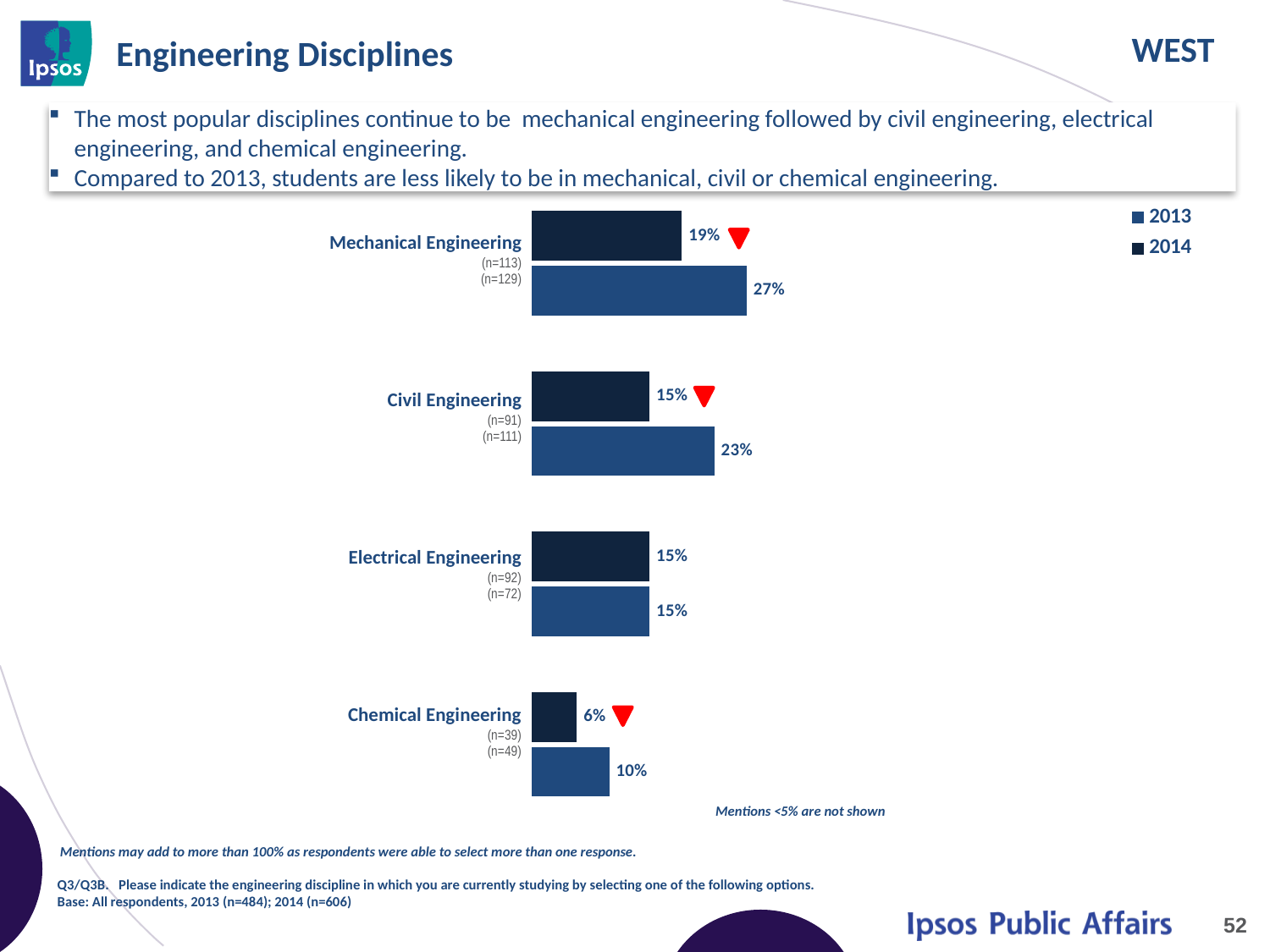
What value is shown for both bars of Electrical Engineering? 15% How many series does the chart legend list? 2 Which discipline has the lowest value in the chart? Chemical Engineering How many engineering disciplines are shown in the chart? 4 What is the larger of the two values shown for Mechanical Engineering? 27% What is the difference between the two values shown for Chemical Engineering? 4 percentage points What is the difference between the two values shown for Mechanical Engineering? 8 percentage points What kind of chart is shown on the slide? bar chart What is the difference between the two values shown for Civil Engineering? 8 percentage points What are the two series listed in the chart legend? 2013 and 2014 What is the smaller of the two values shown for Mechanical Engineering? 19% Which discipline has the highest value in the chart? Mechanical Engineering